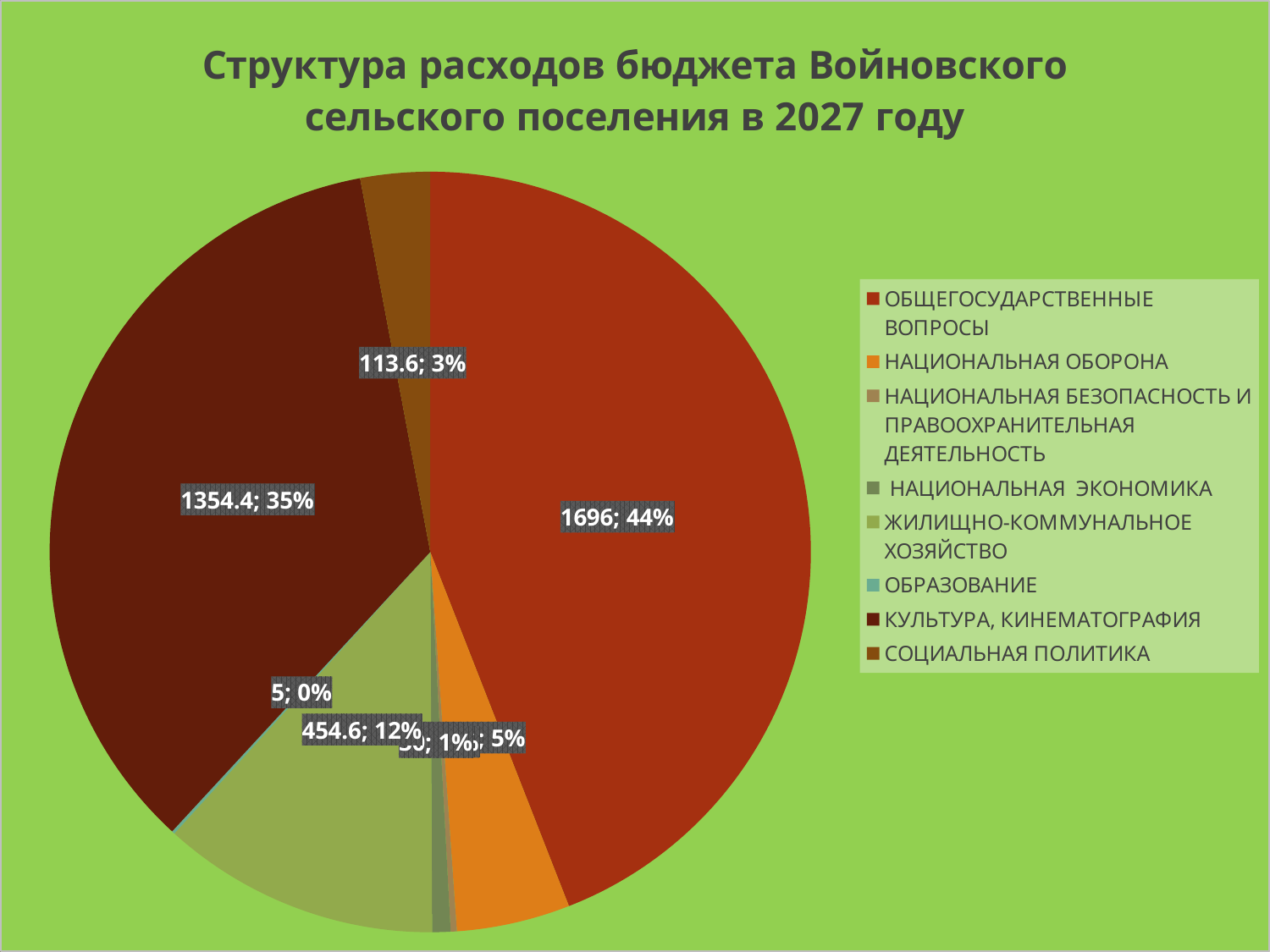
Which category has the smallest slice of the pie? ОБРАЗОВАНИЕ What share of the pie does КУЛЬТУРА, КИНЕМАТОГРАФИЯ represent? 35% What kind of chart is shown on the slide? pie chart How many categories does the legend list? 8 What is the difference between the values for ОБЩЕГОСУДАРСТВЕННЫЕ ВОПРОСЫ and КУЛЬТУРА, КИНЕМАТОГРАФИЯ? 341.6 What value is shown for ЖИЛИЩНО-КОММУНАЛЬНОЕ ХОЗЯЙСТВО? 454.6 What share of the pie does ЖИЛИЩНО-КОММУНАЛЬНОЕ ХОЗЯЙСТВО represent? 12% What value is shown for КУЛЬТУРА, КИНЕМАТОГРАФИЯ? 1354.4 Which is larger, the slice for ЖИЛИЩНО-КОММУНАЛЬНОЕ ХОЗЯЙСТВО or the slice for СОЦИАЛЬНАЯ ПОЛИТИКА? ЖИЛИЩНО-КОММУНАЛЬНОЕ ХОЗЯЙСТВО What value is shown for ОБЩЕГОСУДАРСТВЕННЫЕ ВОПРОСЫ? 1696 Which category has the largest slice of the pie? ОБЩЕГОСУДАРСТВЕННЫЕ ВОПРОСЫ What value is shown for СОЦИАЛЬНАЯ ПОЛИТИКА? 113.6